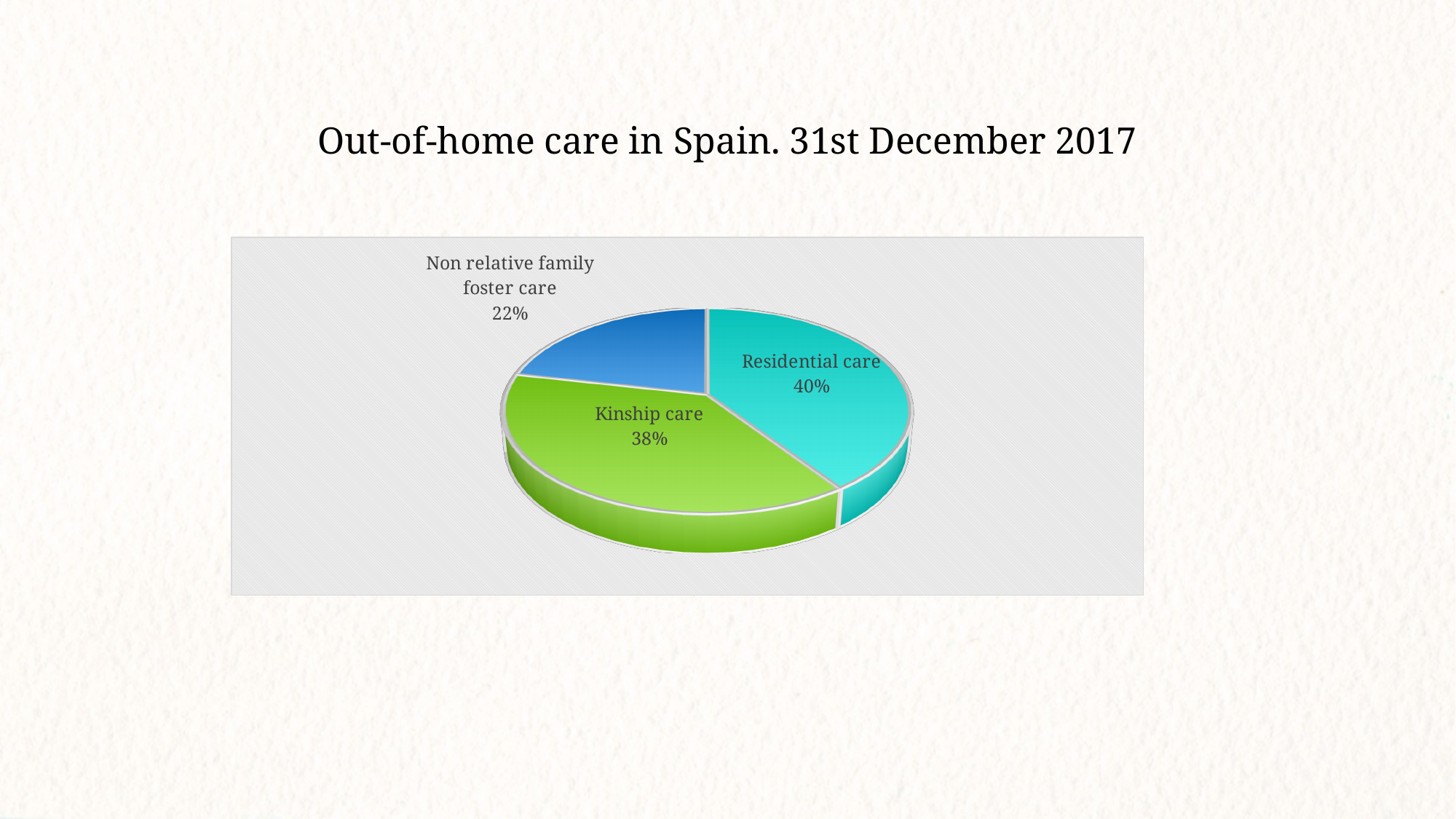
Which is larger, the share for Kinship care or the share for Non relative family foster care? Kinship care What is the title of the slide above the chart? Out-of-home care in Spain. 31st December 2017 What share of out-of-home care is Kinship care? 38% What share of out-of-home care is Residential care? 40% What kind of chart is shown on the slide? Pie chart Which category has the smallest share of the pie? Non relative family foster care What colour is the Kinship care slice? Green How many categories are shown in the pie chart? 3 What is the difference in percentage points between Kinship care and Non relative family foster care? 16 What is the difference in percentage points between Residential care and Non relative family foster care? 18 What share of out-of-home care is Non relative family foster care? 22% Which category has the largest share of the pie? Residential care